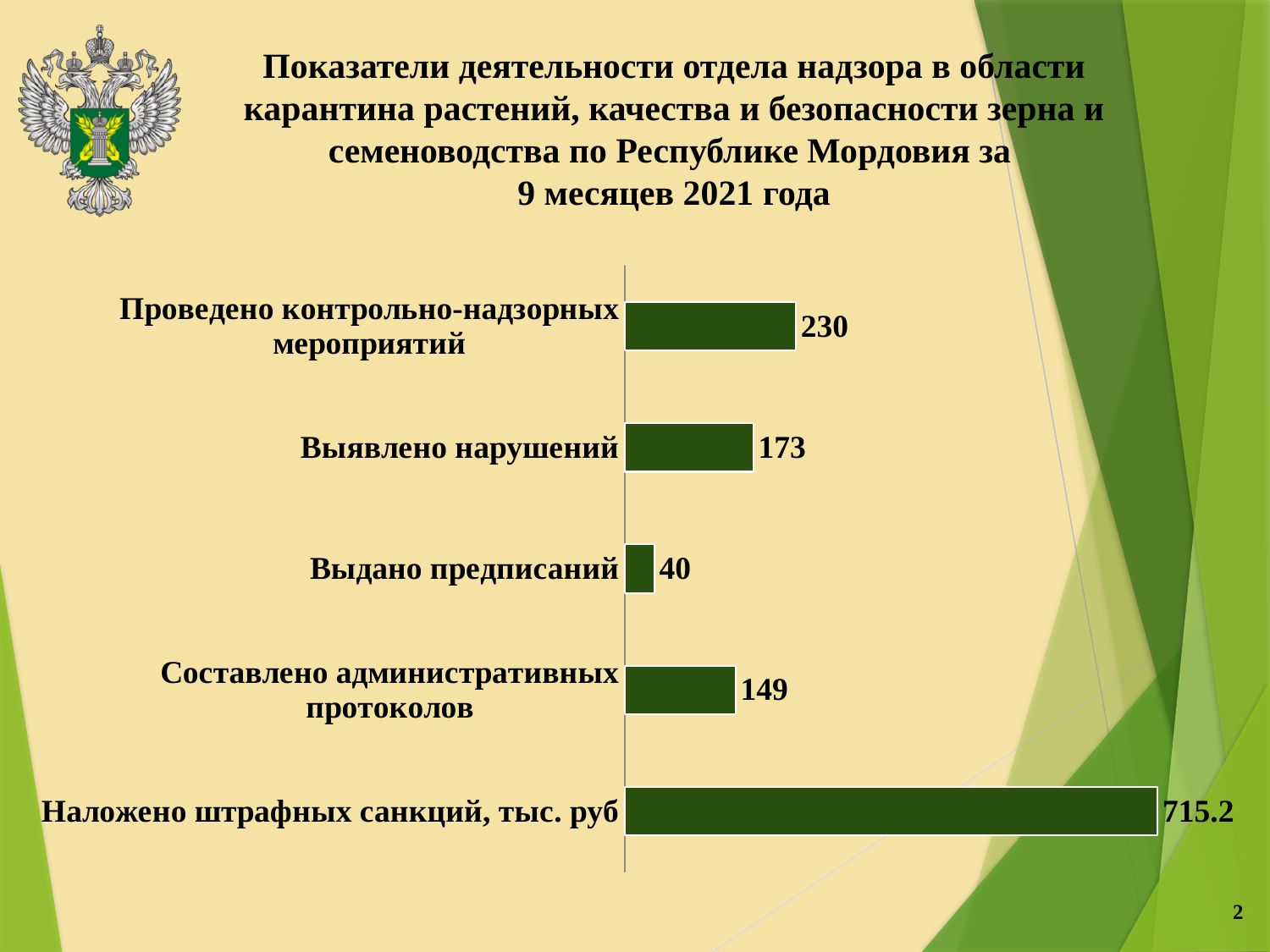
Which category has the lowest value? Выдано предписаний What is the difference between "Проведено контрольно-надзорных мероприятий" and "Выявлено нарушений"? 57 How many categories are shown in the chart? 5 What is the difference between "Выявлено нарушений" and "Составлено административных протоколов"? 24 What value is shown for "Наложено штрафных санкций, тыс. руб"? 715.2 Which category has the highest value? Наложено штрафных санкций, тыс. руб Which is larger: "Составлено административных протоколов" or "Выдано предписаний"? Составлено административных протоколов What kind of chart is shown on the slide? Bar chart What value is shown for "Составлено административных протоколов"? 149 What value is shown for "Выявлено нарушений"? 173 What value is shown for "Проведено контрольно-надзорных мероприятий"? 230 What value is shown for "Выдано предписаний"? 40